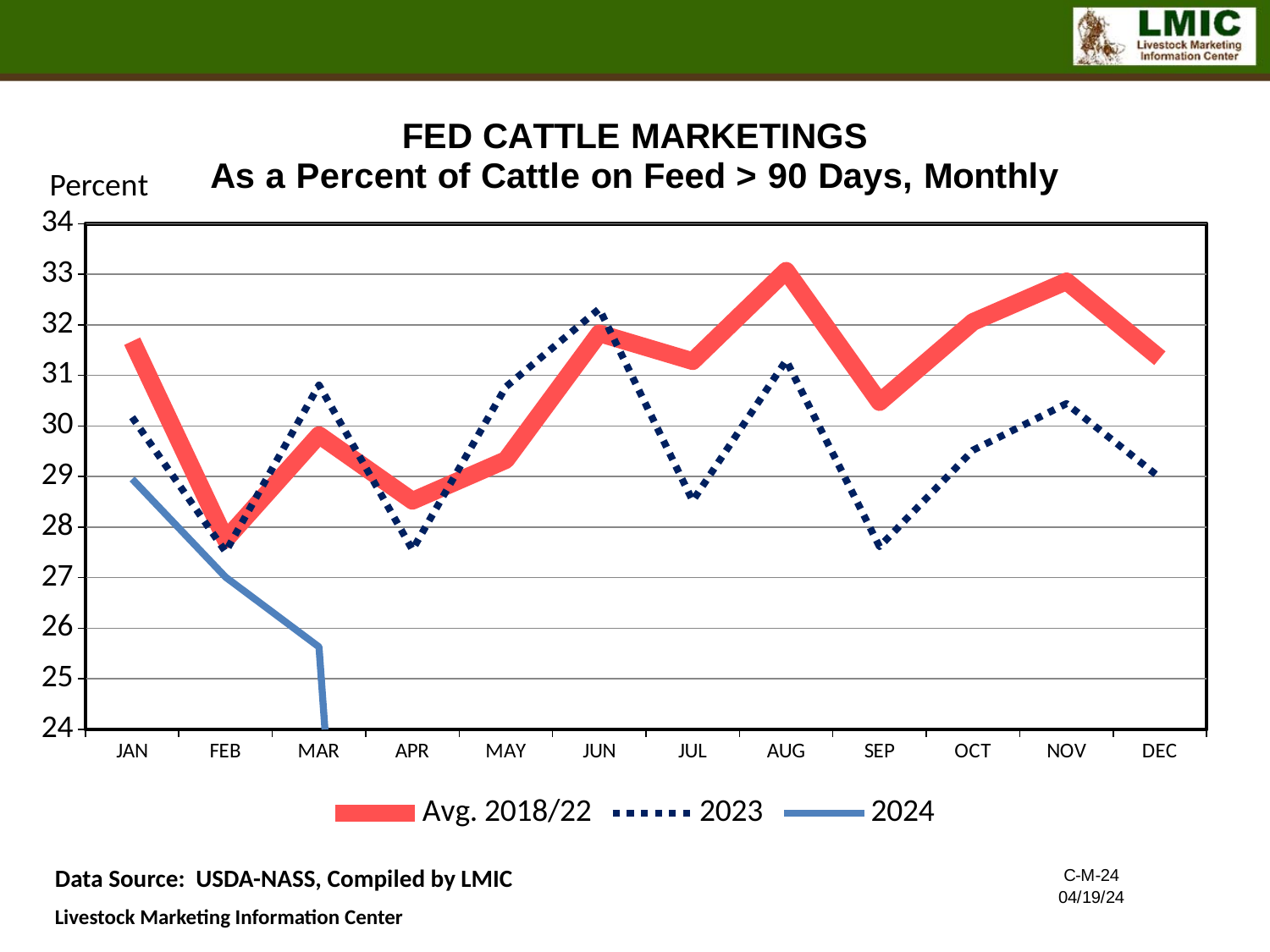
Is the Avg. 2018/22 value for JAN greater or less than 31? greater In which month is the Avg. 2018/22 series at its lowest? FEB In which month does the 2023 series reach its highest value? JUN How many months are shown along the x axis? 12 Does the 2024 series rise or fall from JAN to MAR? fall Is the 2023 value for SEP greater or less than 28? less In AUG, which series is higher: Avg. 2018/22 or 2023? Avg. 2018/22 Is the 2024 value for MAR greater or less than 26? less What kind of chart is shown on the slide? line chart How many series does the legend list? 3 In MAY, which series is higher: Avg. 2018/22 or 2023? 2023